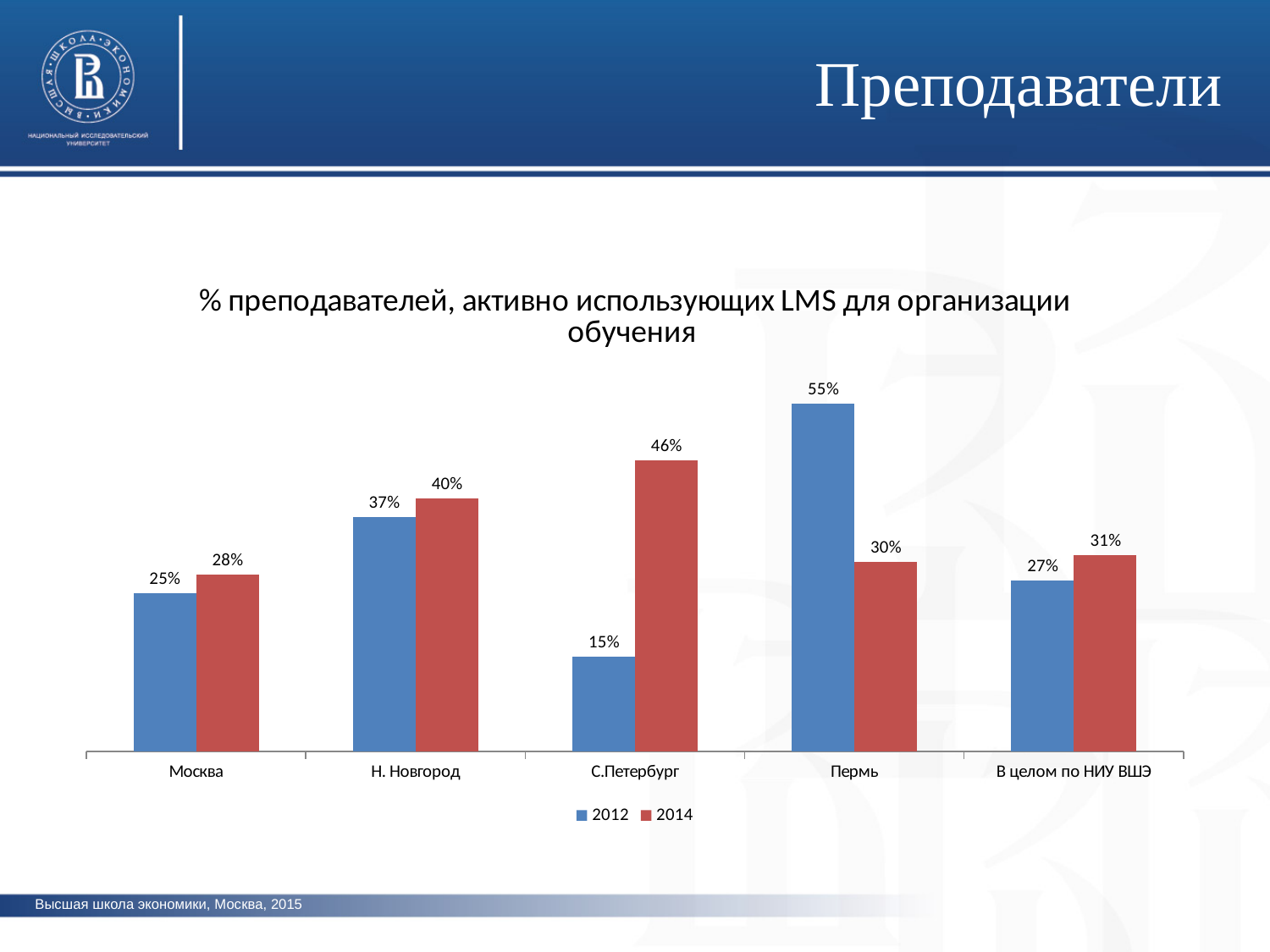
What kind of chart is shown on the slide? Bar chart Which is larger for Пермь: the 2012 value or the 2014 value? 2012 What is the value for Москва in 2012? 25% What is the difference between the 2014 and 2012 values for С.Петербург? 31% How many series does the legend list? 2 Which category has the highest value in the 2014 series? С.Петербург What is the value for Пермь in 2012? 55% Which category has the lowest value in the 2012 series? С.Петербург How many categories are shown on the x axis? 5 Which category has the highest value in the 2012 series? Пермь What is the value for В целом по НИУ ВШЭ in 2014? 31% What is the value for С.Петербург in 2014? 46%